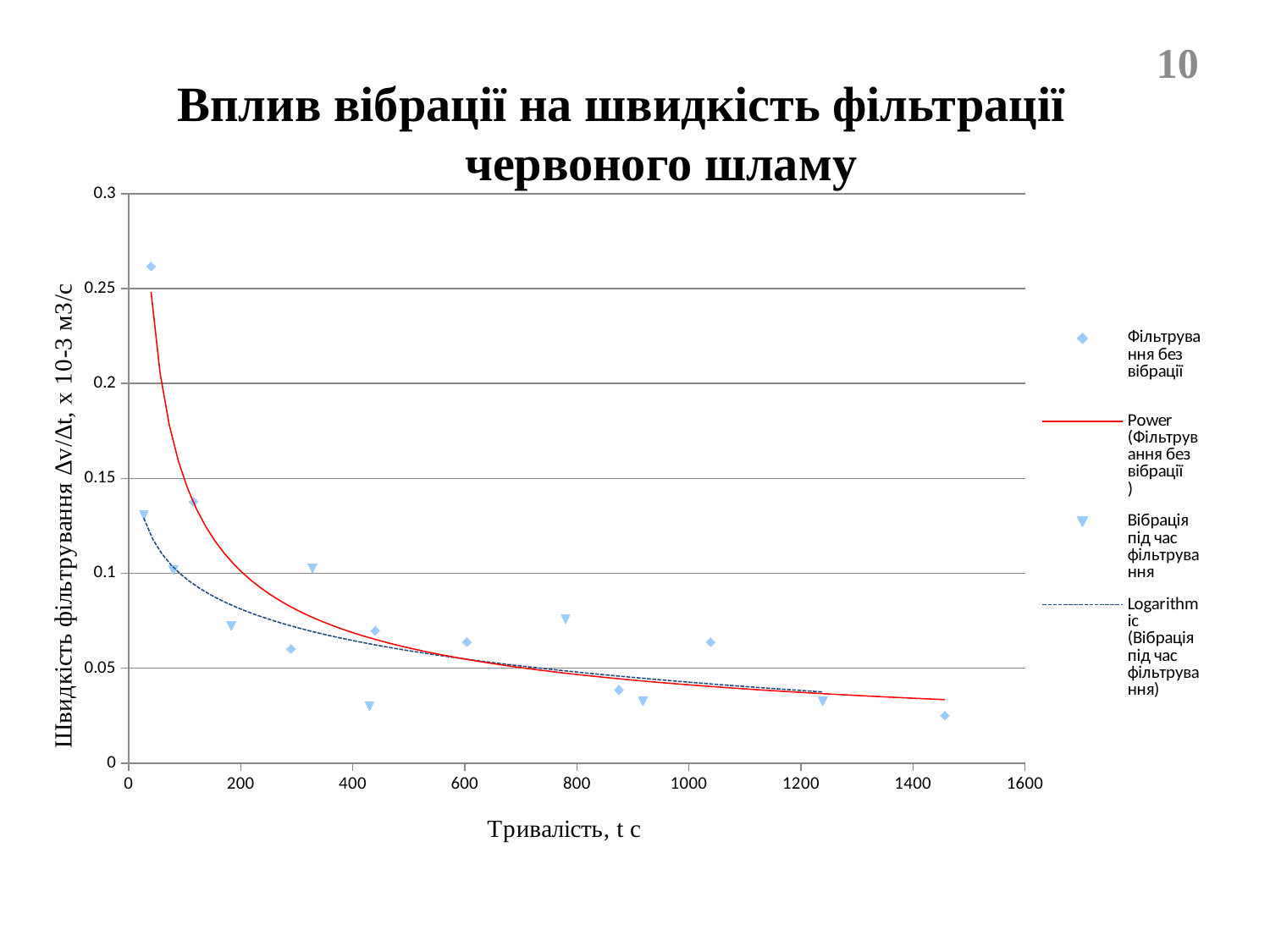
Is the value of the "Вібрація під час фільтрування" point near Тривалість 400 greater or less than 0.05? less Which is larger: the first point of "Фільтрування без вібрації" (near Тривалість 0) or the first point of "Вібрація під час фільтрування" (near Тривалість 0)? Фільтрування без вібрації Which series contains the single highest plotted point on the chart? Фільтрування без вібрації Is the value of the "Фільтрування без вібрації" point near Тривалість 1400 greater or less than 0.05? less How many entries does the chart legend list? 4 Is the highest point of the "Фільтрування без вібрації" series greater or less than 0.2? greater Do the values of the "Фільтрування без вібрації" series generally rise or fall as Тривалість increases? fall Do the values of the "Вібрація під час фільтрування" series generally rise or fall as Тривалість increases? fall What kind of chart is shown on the slide? scatter chart What is the title of the chart? Вплив вібрації на швидкість фільтрації червоного шламу What colour is the Power trendline for "Фільтрування без вібрації"? red